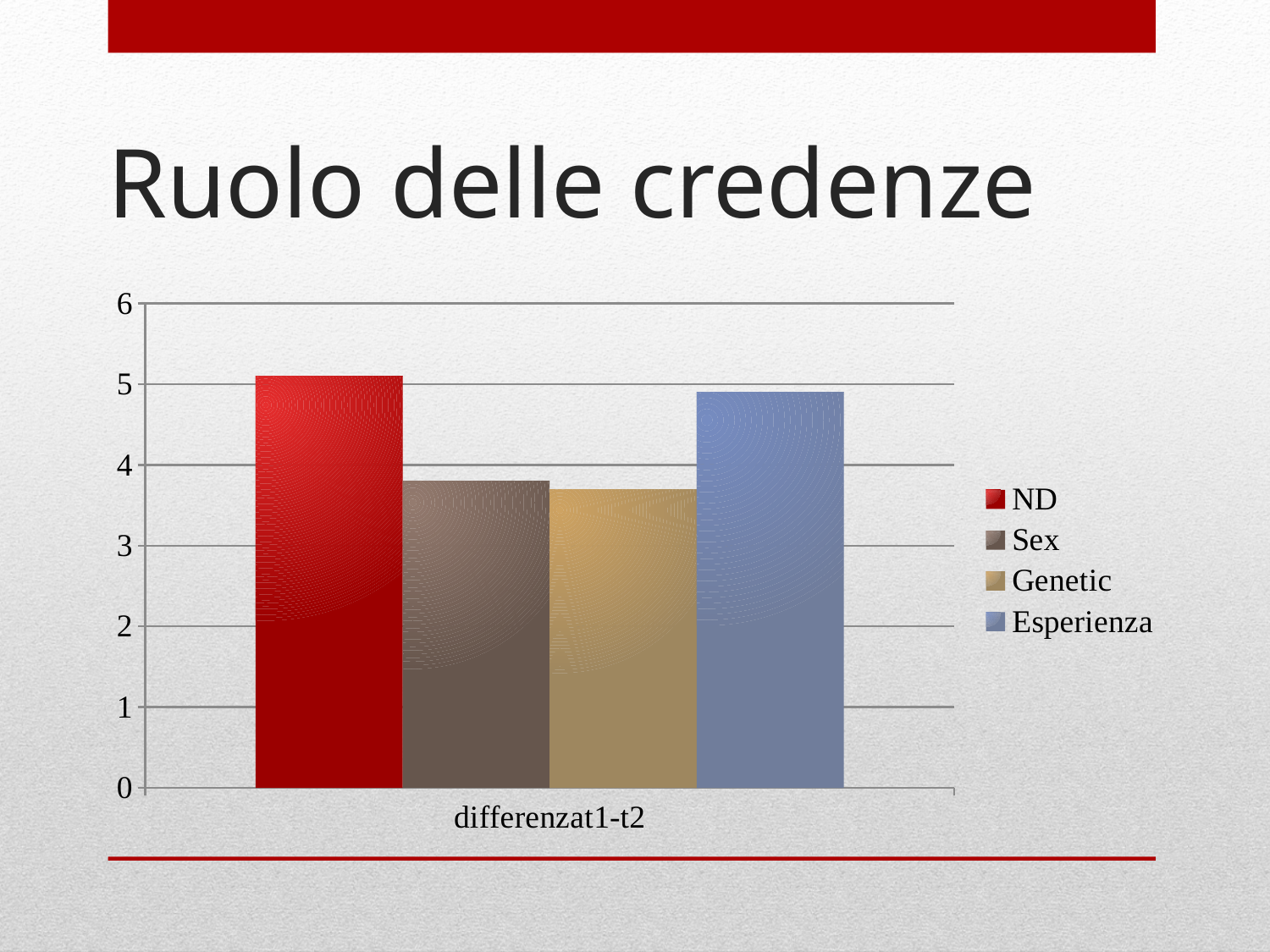
Which is larger, the value for ND or the value for Sex? ND Which series has the highest bar? ND Is the value for Sex greater or less than 4? less What kind of chart is shown on the slide? bar chart What is the title of the slide containing the chart? Ruolo delle credenze Is the value for ND greater or less than 5? greater What is the category label shown on the x axis? differenzat1-t2 How many series does the legend list? 4 How many categories are shown on the x axis? 1 Is the value for Genetic greater or less than 3? greater Which is larger, the value for Genetic or the value for Esperienza? Esperienza